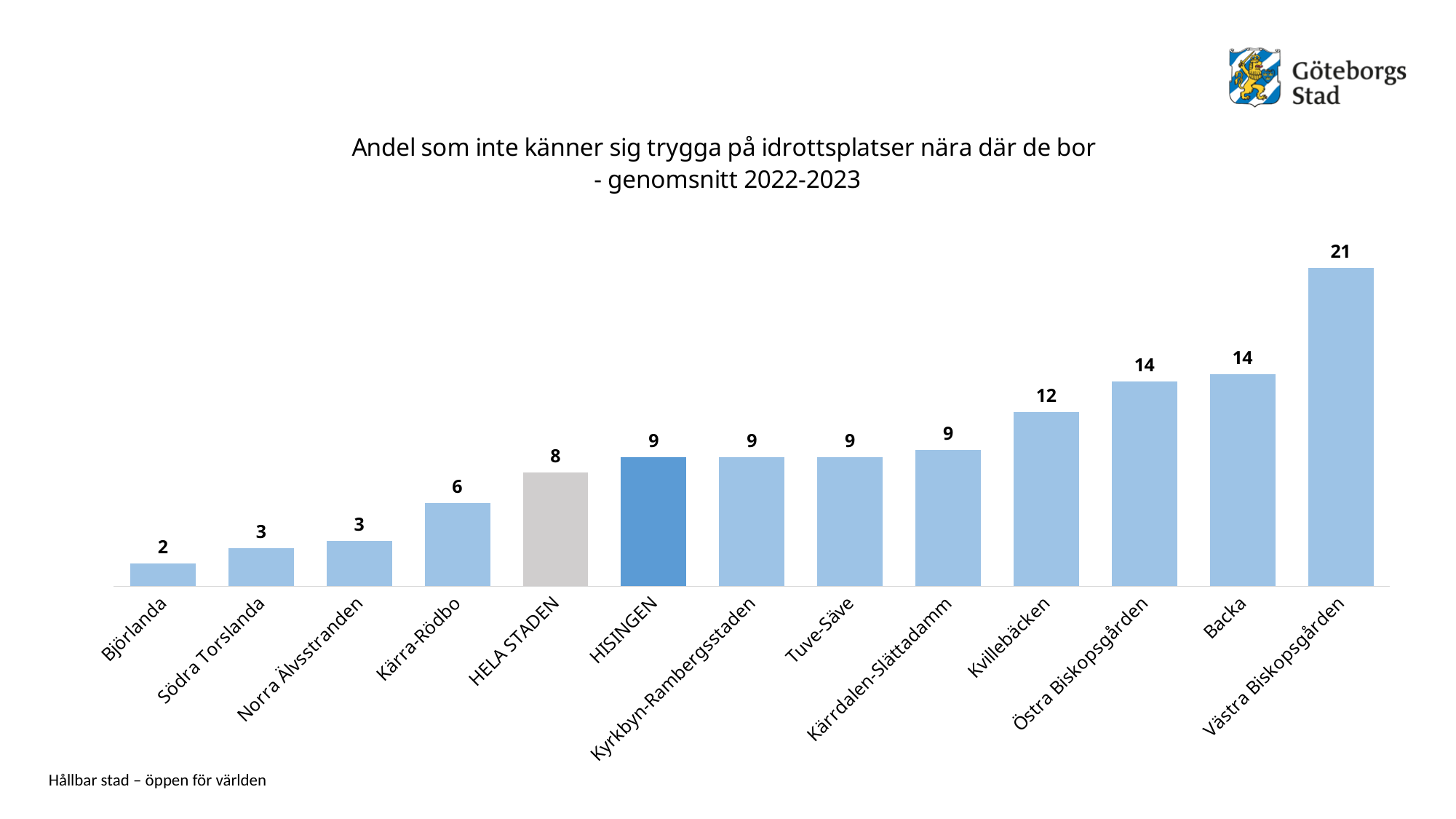
What is the value for HELA STADEN? 8 What is the value for Kvillebäcken? 12 What is the difference between the values for HISINGEN and HELA STADEN? 1 Do the values rise or fall from left to right along the x axis? Rise Which category has the lowest value? Björlanda Which has a larger value, Kärra-Rödbo or Kvillebäcken? Kvillebäcken How many categories are shown on the x axis? 13 What is the value for HISINGEN? 9 What kind of chart is shown on the slide? Bar chart What is the difference between the values for Västra Biskopsgården and Backa? 7 Which category has the highest value? Västra Biskopsgården What is the value for Björlanda? 2